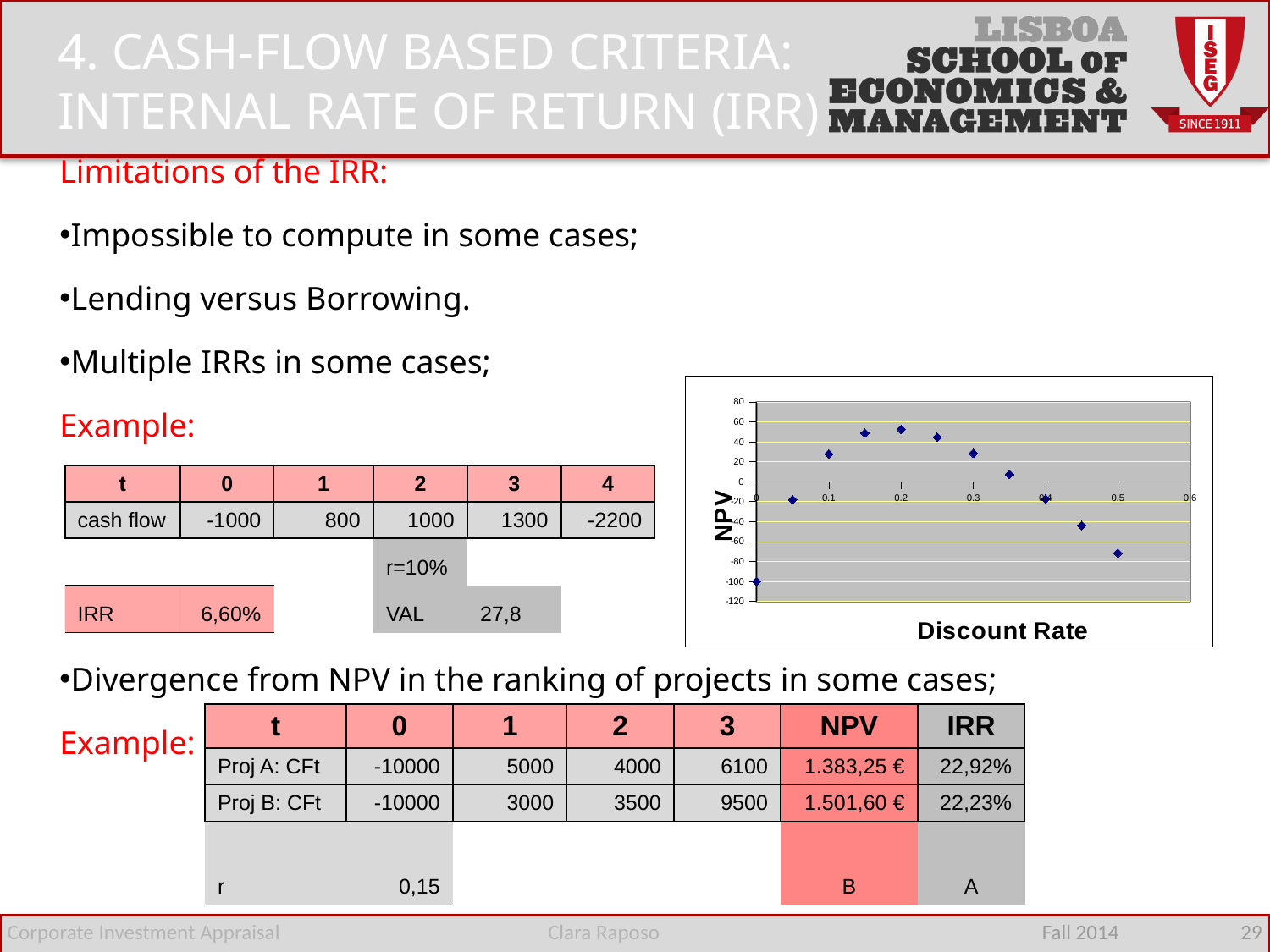
At which discount rate is the plotted NPV lowest? 0 What kind of chart is shown on the slide? scatter chart Is the NPV at a discount rate of 0.2 greater or less than 40? greater Which has the larger NPV in the chart: a discount rate of 0.45 or 0.5? 0.45 Is the NPV at a discount rate of 0.1 greater or less than 20? greater What is the NPV plotted at a discount rate of 0? -100 What is the label of the horizontal axis of the chart? Discount Rate How many data points are plotted in the chart? 11 What is the label of the vertical axis of the chart? NPV Which has the larger NPV in the chart: a discount rate of 0.1 or 0.4? 0.1 Is the NPV at a discount rate of 0.5 greater or less than -60? less How does the NPV change as the discount rate increases from 0 to 0.5 in the chart? rises then falls